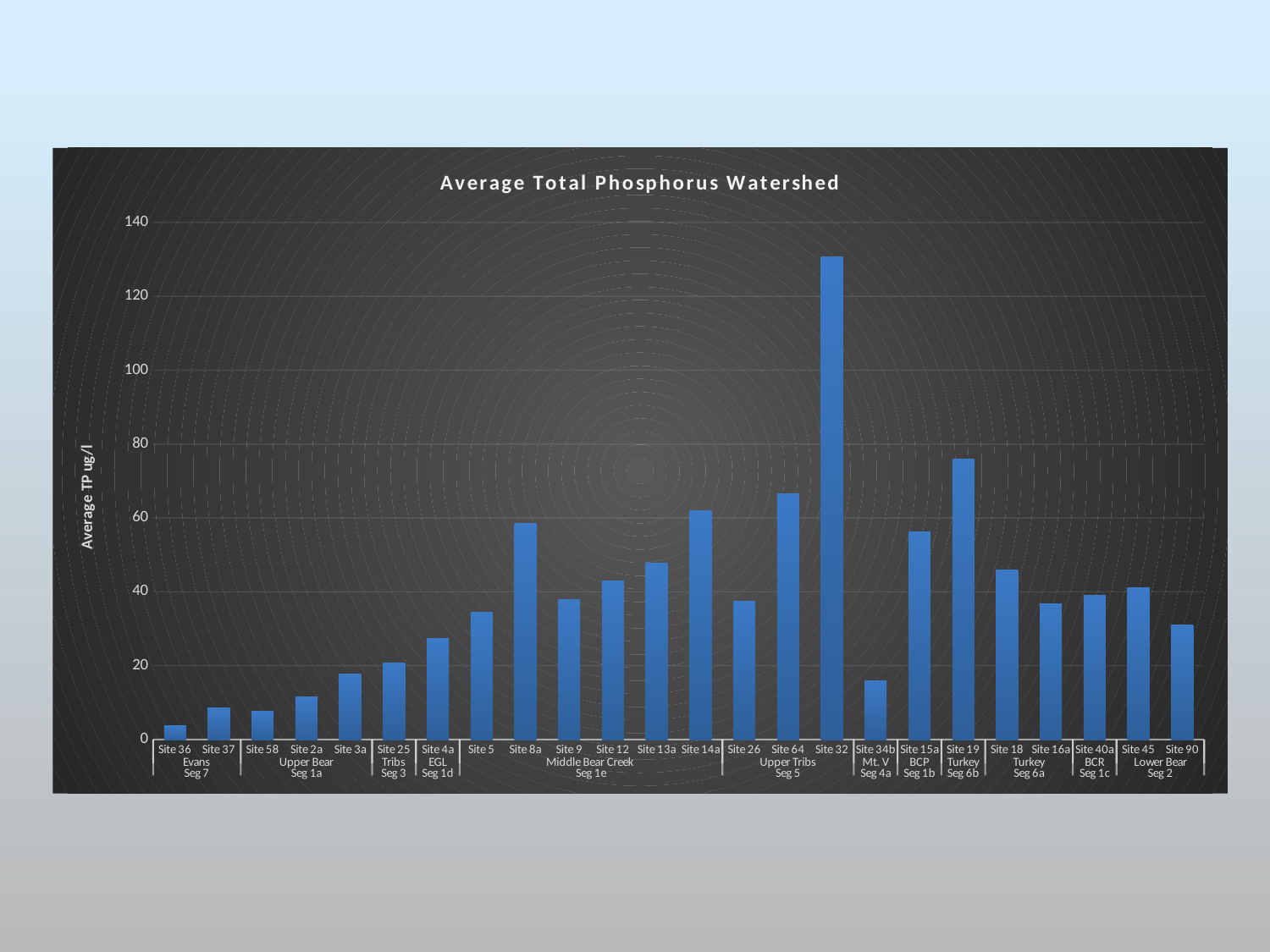
Is the value for Site 34b greater or less than 20? less Which has a higher value, Site 8a or Site 9? Site 8a Which site has the lowest average total phosphorus? Site 36 What is the title of the chart? Average Total Phosphorus Watershed Is the value for Site 64 greater or less than 60? greater What is the label on the vertical axis of the chart? Average TP ug/l Which site has the highest average total phosphorus? Site 32 How many sites (bars) are plotted on the chart? 24 Is the value for Site 13a greater or less than 40? greater Do the values rise or fall across the Upper Bear Seg 1a sites from Site 58 to Site 3a? rise What kind of chart is shown on the slide? bar chart